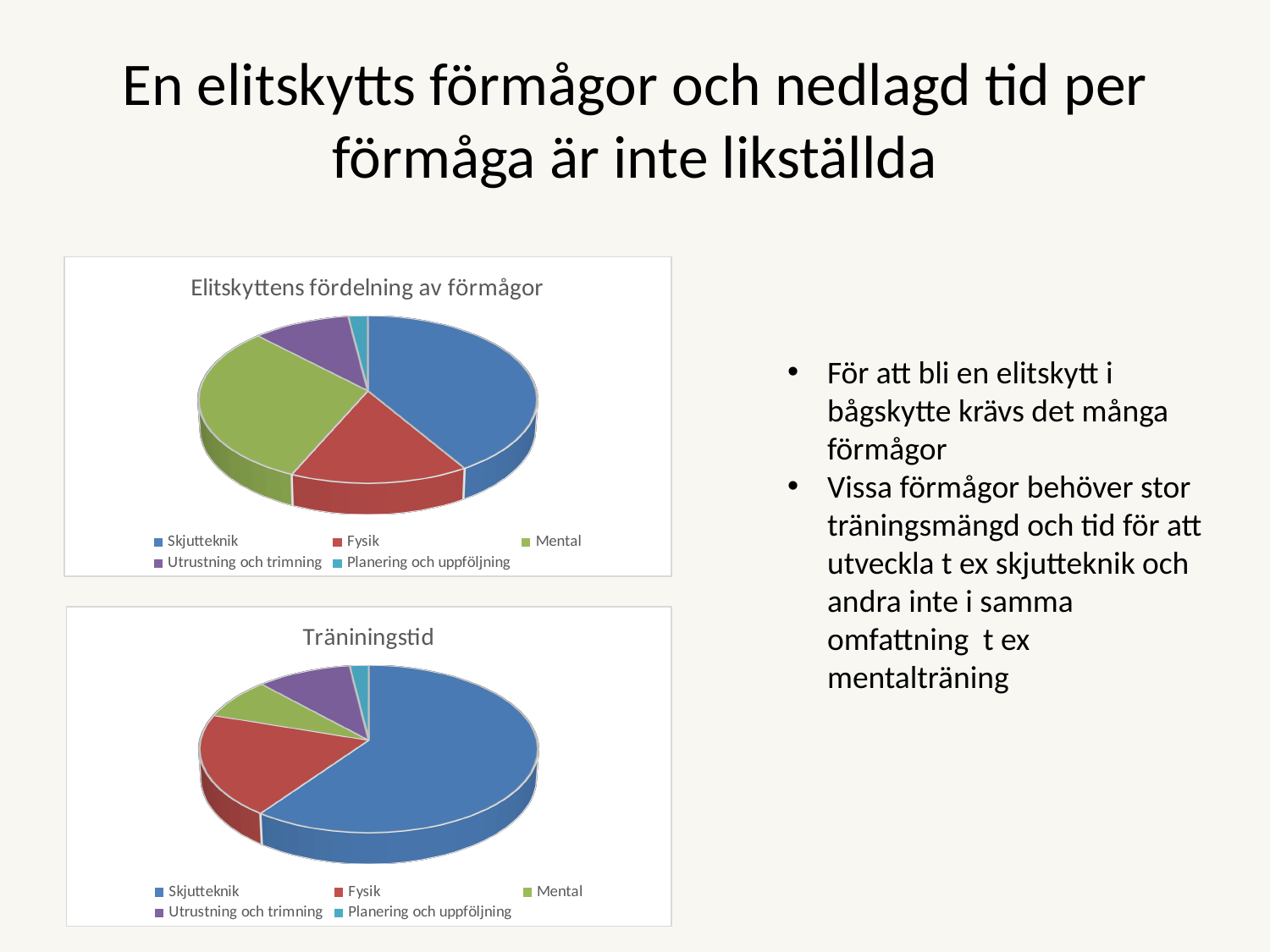
In the chart titled "Elitskyttens fördelning av förmågor", which slice is larger, Mental or Fysik? Mental What is the title of the top chart on the slide? Elitskyttens fördelning av förmågor In the chart titled "Elitskyttens fördelning av förmågor", which category has the smallest slice? Planering och uppföljning In the chart titled "Träniningstid", which category has the smallest slice? Planering och uppföljning In the chart titled "Träniningstid", which category has the largest slice? Skjutteknik What kind of chart is the chart titled "Elitskyttens fördelning av förmågor"? pie chart In the chart titled "Elitskyttens fördelning av förmågor", which category has the largest slice? Skjutteknik What kind of chart is the chart titled "Träniningstid"? pie chart In the chart titled "Elitskyttens fördelning av förmågor", how many slices does the pie have? 5 In the chart titled "Träniningstid", what colour is the Skjutteknik slice? blue In the chart titled "Träniningstid", how many entries does the legend list? 5 In the chart titled "Träniningstid", which slice is larger, Fysik or Mental? Fysik